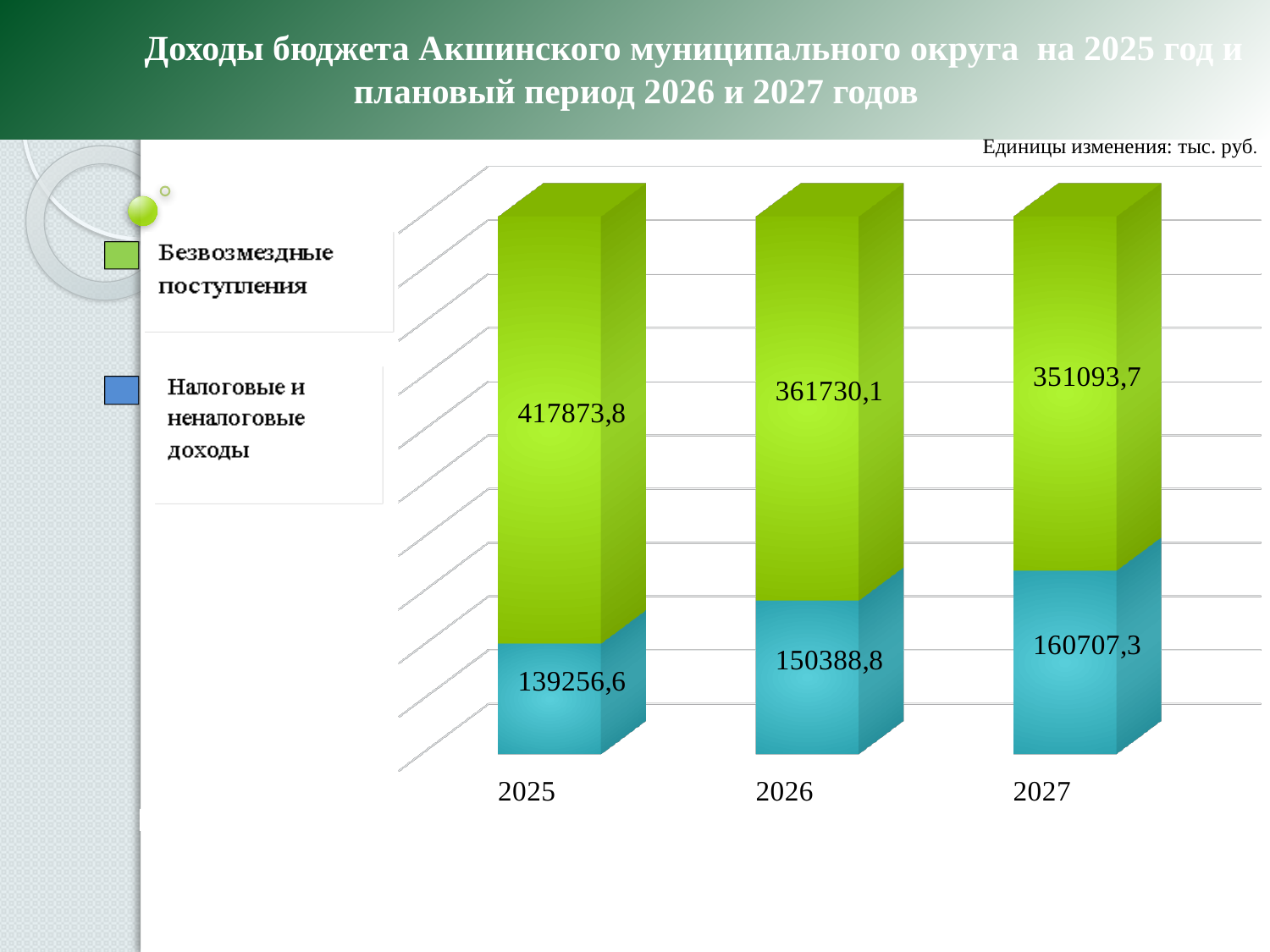
What kind of chart is shown on the slide? Stacked bar chart What is the total of the stacked bar for 2025? 557130,4 How many series does the legend list? 2 Which is larger: Налоговые и неналоговые доходы in 2026 or in 2027? 2027 In which year is Безвозмездные поступления the highest? 2025 In which year is Налоговые и неналоговые доходы the lowest? 2025 What is the value of Налоговые и неналоговые доходы for 2026? 150388,8 Does Налоговые и неналоговые доходы rise or fall from 2025 to 2027? Rise What is the value of Безвозмездные поступления for 2025? 417873,8 How many years are shown on the x axis? 3 What is the value of Налоговые и неналоговые доходы for 2027? 160707,3 By how much does Безвозмездные поступления in 2025 exceed that in 2026? 56143,7